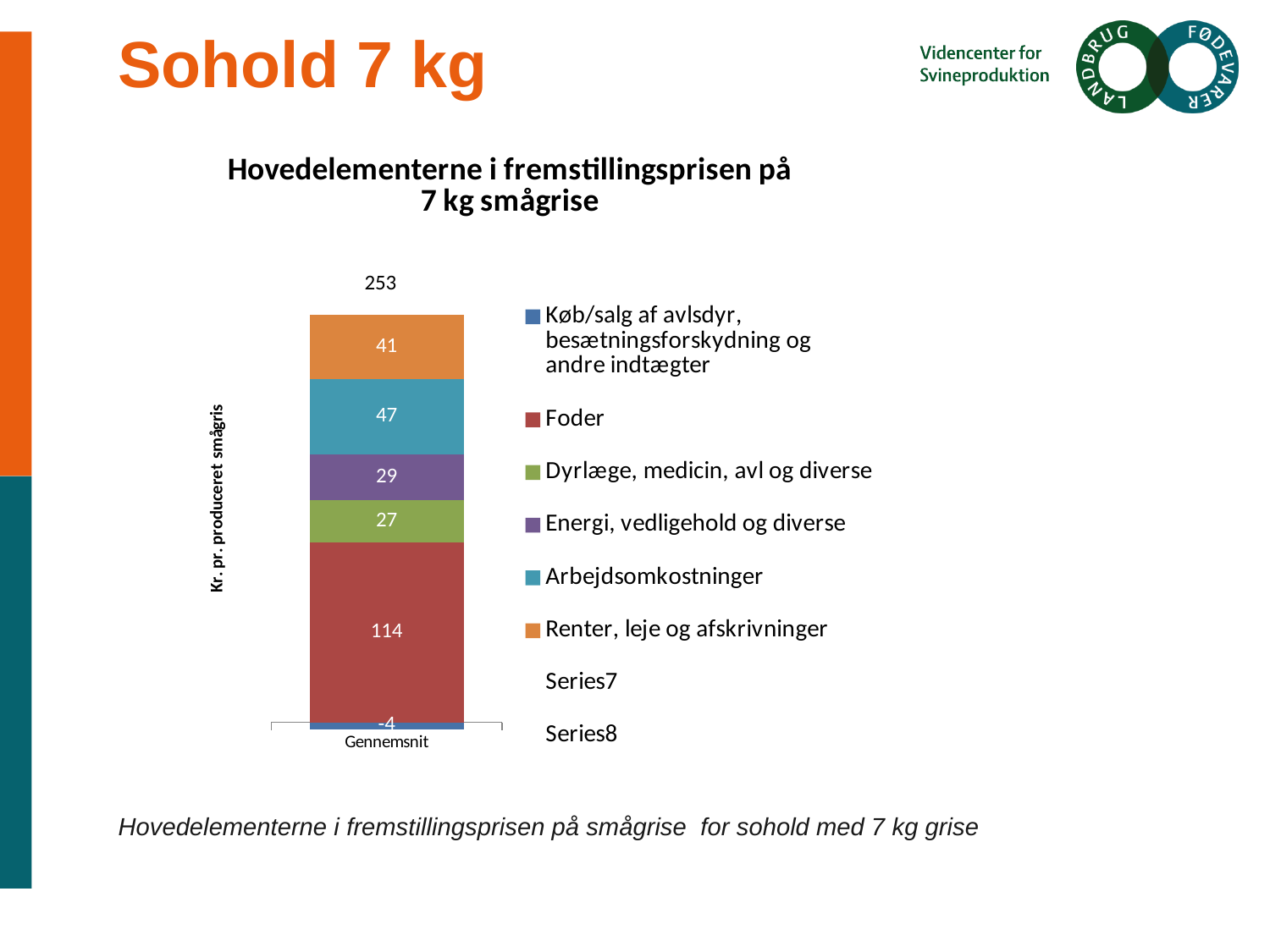
What is the total shown above the Gennemsnit bar? 253 Which is larger, the value for Arbejdsomkostninger or the value for Renter, leje og afskrivninger? Arbejdsomkostninger What is the value for Energi, vedligehold og diverse in the chart? 29 What is the label of the category on the x axis? Gennemsnit What is the value for Renter, leje og afskrivninger in the chart? 41 What is the value for Arbejdsomkostninger in the chart? 47 What is the difference between the Foder value and the Arbejdsomkostninger value? 67 What is the value for Dyrlæge, medicin, avl og diverse in the chart? 27 What kind of chart is shown on the slide? Stacked bar chart What is the value for Foder in the chart? 114 What is the value for Køb/salg af avlsdyr, besætningsforskydning og andre indtægter in the chart? -4 Which cost element has the largest value in the stacked bar? Foder